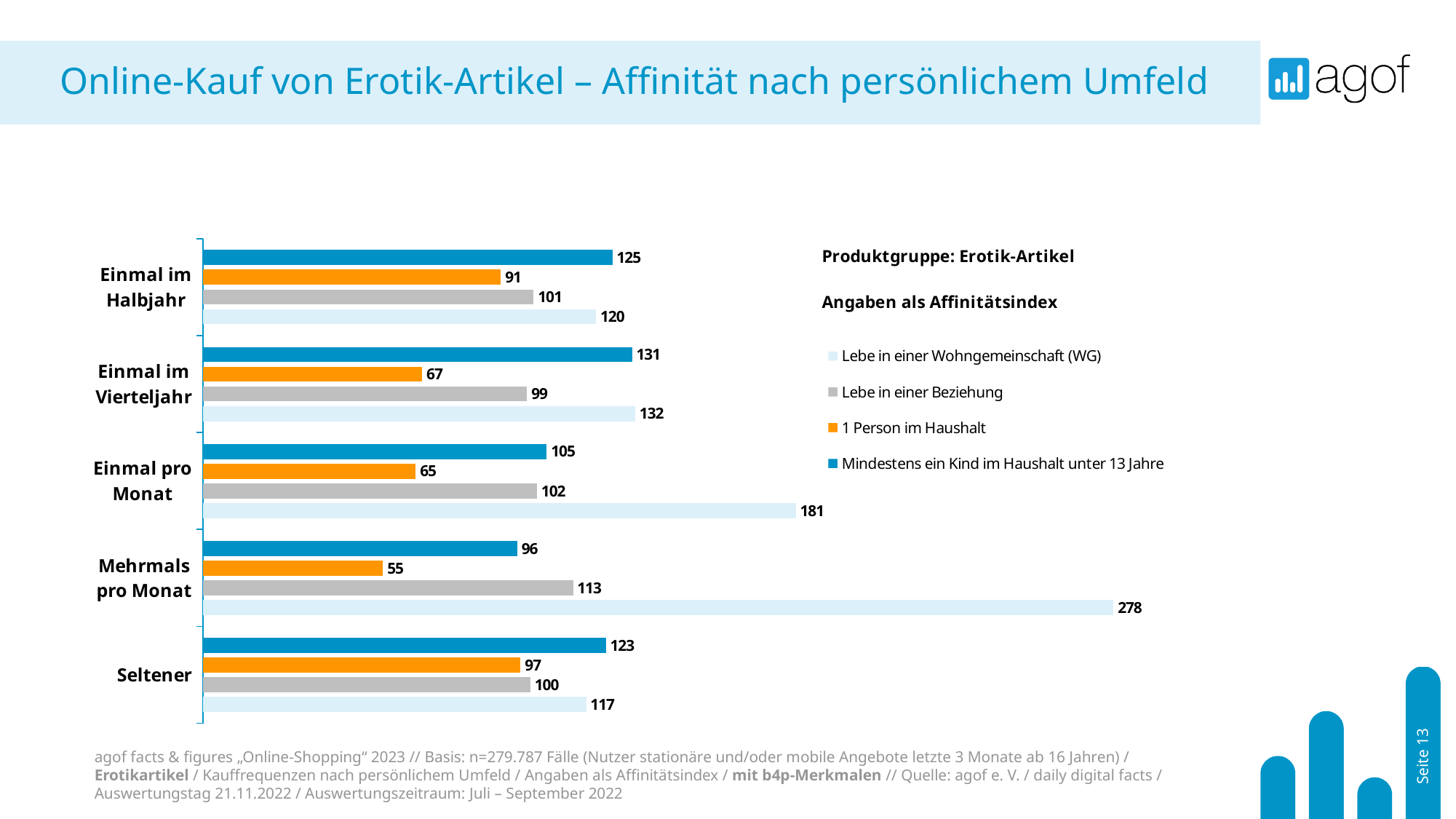
How many purchase-frequency categories are shown on the chart? 5 What is the value for 'Lebe in einer Beziehung' in the 'Einmal pro Monat' category? 102 How many series does the legend list? 4 In the 'Einmal im Halbjahr' category, which is larger: the value for 'Mindestens ein Kind im Haushalt unter 13 Jahre' or for 'Lebe in einer Wohngemeinschaft (WG)'? Mindestens ein Kind im Haushalt unter 13 Jahre What is the value for '1 Person im Haushalt' in the 'Einmal im Vierteljahr' category? 67 What is the value for 'Mindestens ein Kind im Haushalt unter 13 Jahre' in the 'Seltener' category? 123 What is the affinity index for 'Lebe in einer Wohngemeinschaft (WG)' in the 'Mehrmals pro Monat' category? 278 What type of chart is shown on the slide? Bar chart Which colour represents the series '1 Person im Haushalt'? Orange What is the difference between the 'Lebe in einer Wohngemeinschaft (WG)' value and the '1 Person im Haushalt' value in the 'Mehrmals pro Monat' category? 223 Which category has the highest value for 'Lebe in einer Wohngemeinschaft (WG)'? Mehrmals pro Monat Which category has the lowest value for '1 Person im Haushalt'? Mehrmals pro Monat